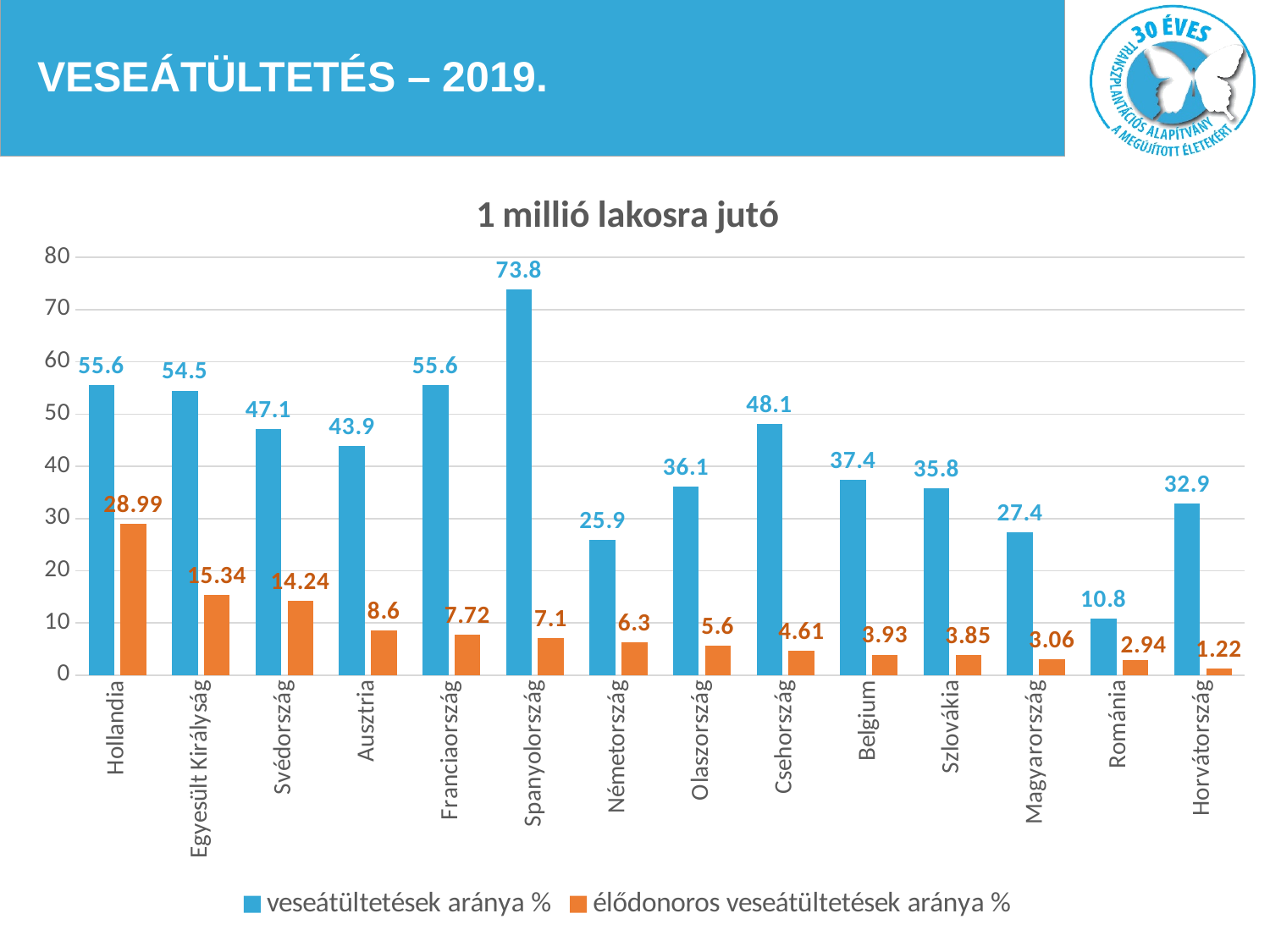
Which has a higher 'veseátültetések aránya %', Csehország or Belgium? Csehország What is the value of 'veseátültetések aránya %' for Magyarország? 27.4 Which country has the highest 'veseátültetések aránya %'? Spanyolország How many countries are shown on the x axis of the chart? 14 Which country has the lowest 'élődonoros veseátültetések aránya %'? Horvátország Which country has the lowest 'veseátültetések aránya %'? Románia What type of chart is shown on the slide? Bar chart What is the value of 'veseátültetések aránya %' for Spanyolország? 73.8 How many series does the legend list? 2 What is the difference between the 'élődonoros veseátültetések aránya %' values for Hollandia and Egyesült Királyság? 13.65 What is the value of 'élődonoros veseátültetések aránya %' for Hollandia? 28.99 What is the difference between the 'veseátültetések aránya %' values for Spanyolország and Hollandia? 18.2